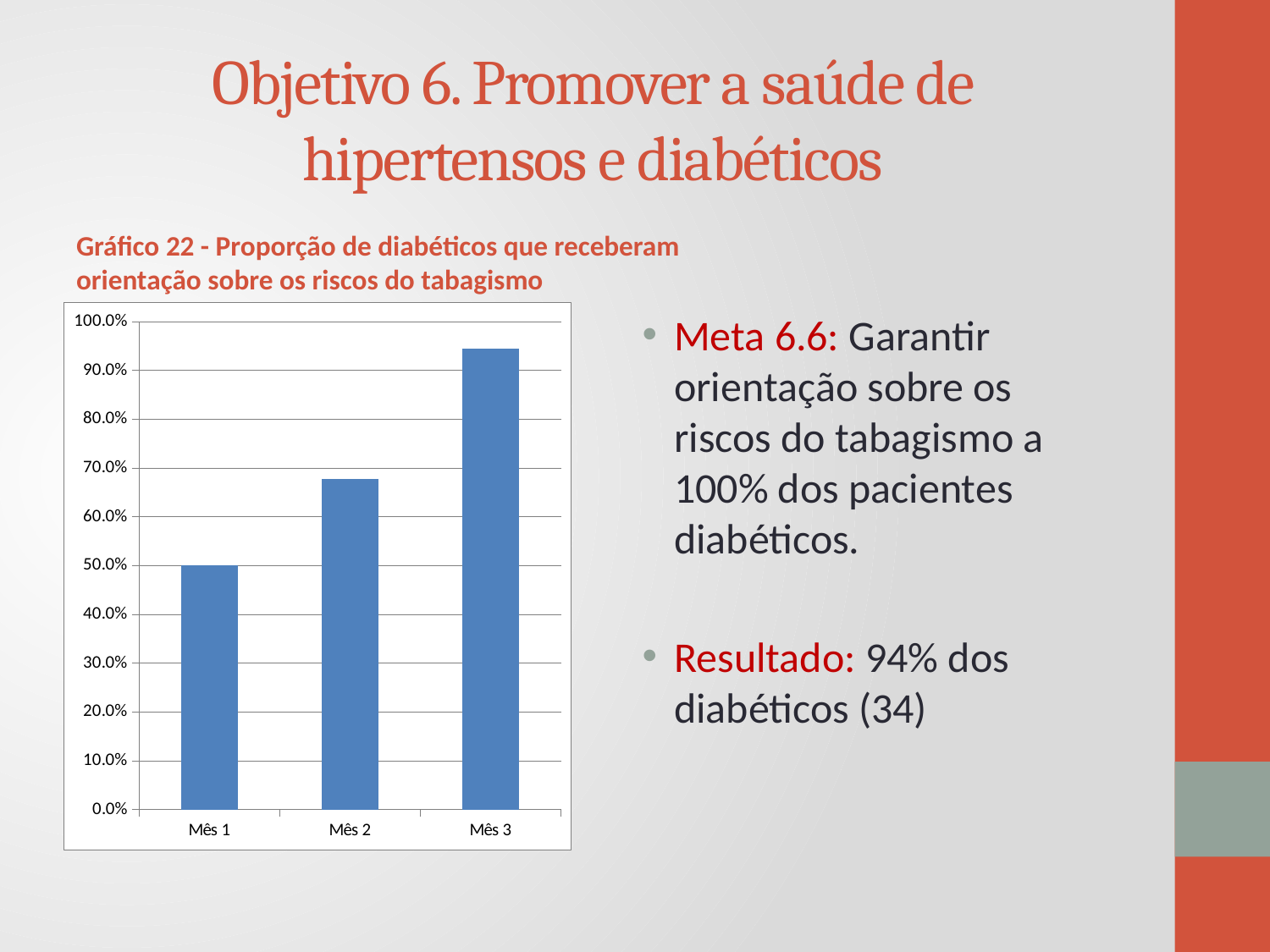
Which month has the lowest value in the chart? Mês 1 Is the value for Mês 2 greater or less than 60.0%? greater Which month has the highest value in the chart? Mês 3 How many categories are plotted on the x axis of the chart? 3 Is the value for Mês 3 greater or less than 100.0%? less Which is larger, the value for Mês 2 or the value for Mês 3? Mês 3 Is the value for Mês 2 greater or less than 70.0%? less What is the value for Mês 1? 50.0% What is the title of the chart? Gráfico 22 - Proporção de diabéticos que receberam orientação sobre os riscos do tabagismo What kind of chart is shown on the slide? bar chart Do the values rise or fall from Mês 1 to Mês 3? rise